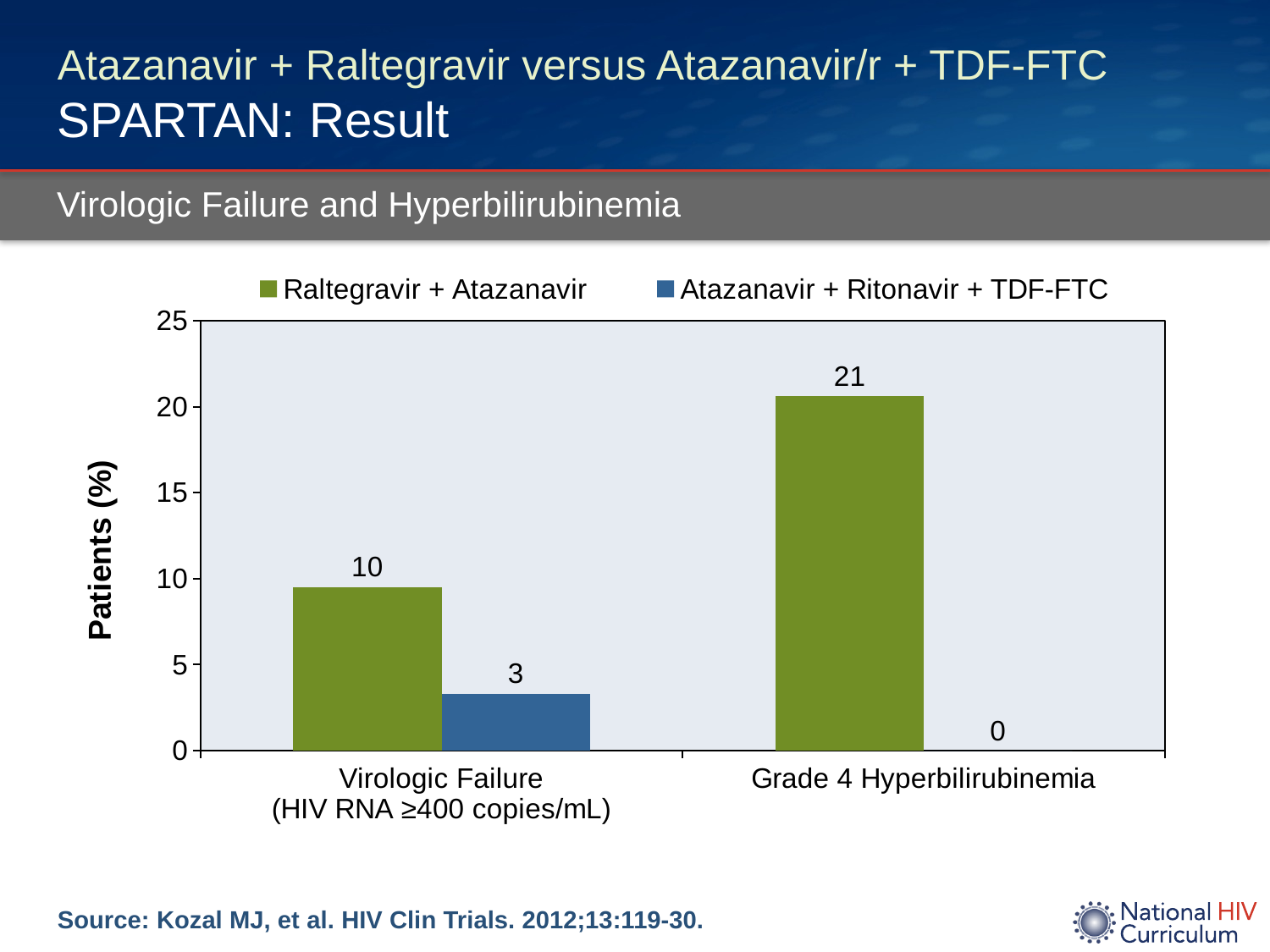
Is the Grade 4 Hyperbilirubinemia value for the Raltegravir + Atazanavir group greater or less than 20? greater What percentage of patients in the Raltegravir + Atazanavir group had Grade 4 Hyperbilirubinemia? 21 Which group had a higher rate of Virologic Failure? Raltegravir + Atazanavir What is the difference in Virologic Failure rates between the Raltegravir + Atazanavir group and the Atazanavir + Ritonavir + TDF-FTC group? 7 What percentage of patients in the Atazanavir + Ritonavir + TDF-FTC group had Grade 4 Hyperbilirubinemia? 0 What percentage of patients in the Atazanavir + Ritonavir + TDF-FTC group had Virologic Failure? 3 What is the difference in Grade 4 Hyperbilirubinemia rates between the two treatment groups? 21 Which bar shows the highest value on the chart? Raltegravir + Atazanavir, Grade 4 Hyperbilirubinemia What percentage of patients in the Raltegravir + Atazanavir group had Virologic Failure? 10 What type of chart is shown on the slide? Bar chart How many series does the legend list? 2 What is the label of the y-axis? Patients (%)